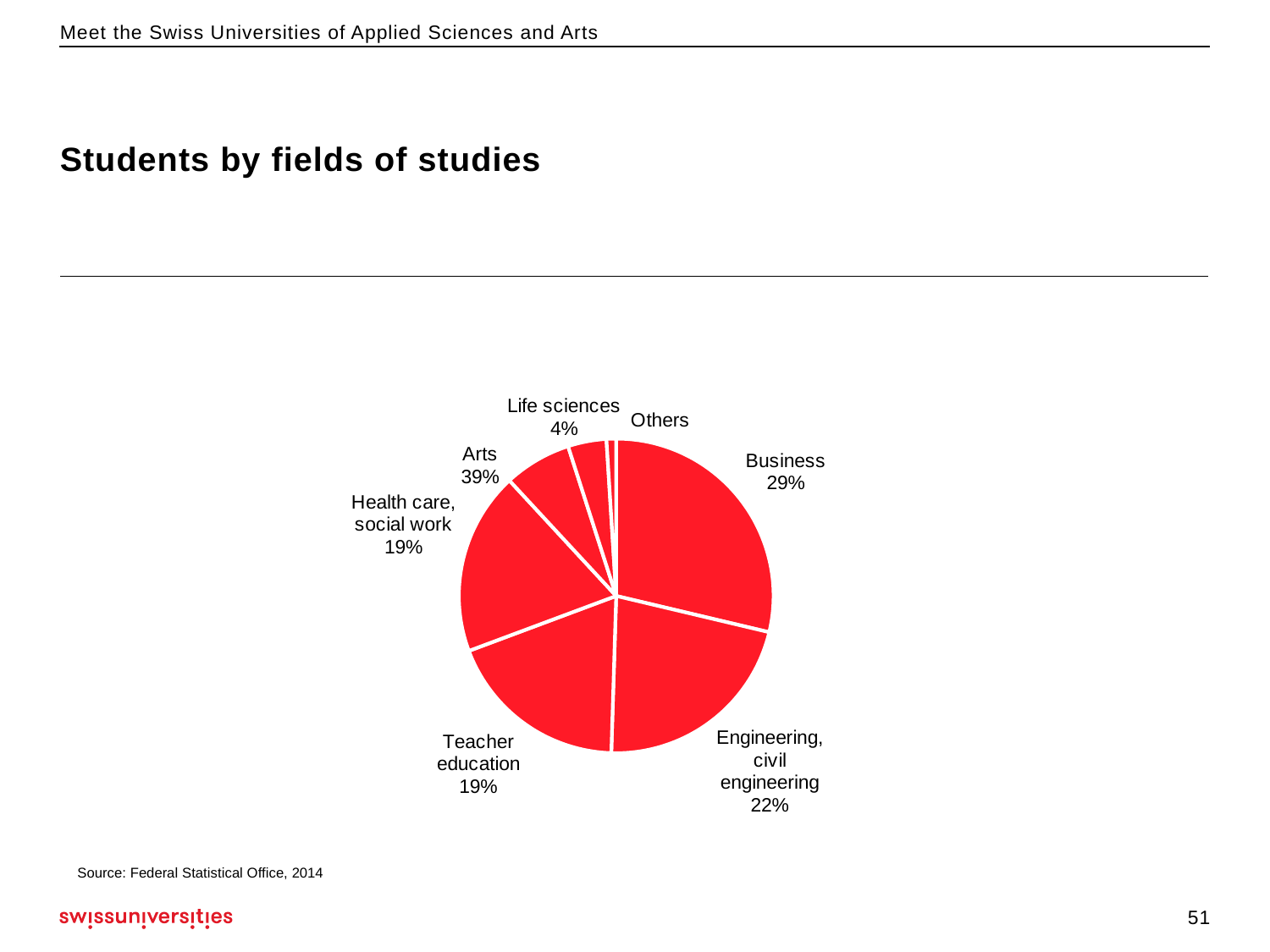
What share of students is in Teacher education? 19% How many slices does the pie chart have? 7 What is the title of the chart on the slide? Students by fields of studies What kind of chart is shown on the slide? pie chart What is the difference in percentage points between Business and Teacher education? 10% Which is larger, the share for Business or the share for Engineering, civil engineering? Business What share of students is in Health care, social work? 19% What is the difference in percentage points between Business and Engineering, civil engineering? 7% Which field has the smallest slice of the pie? Others What share of students is in Business? 29% What share of students is in Engineering, civil engineering? 22% What share of students is in Life sciences? 4%